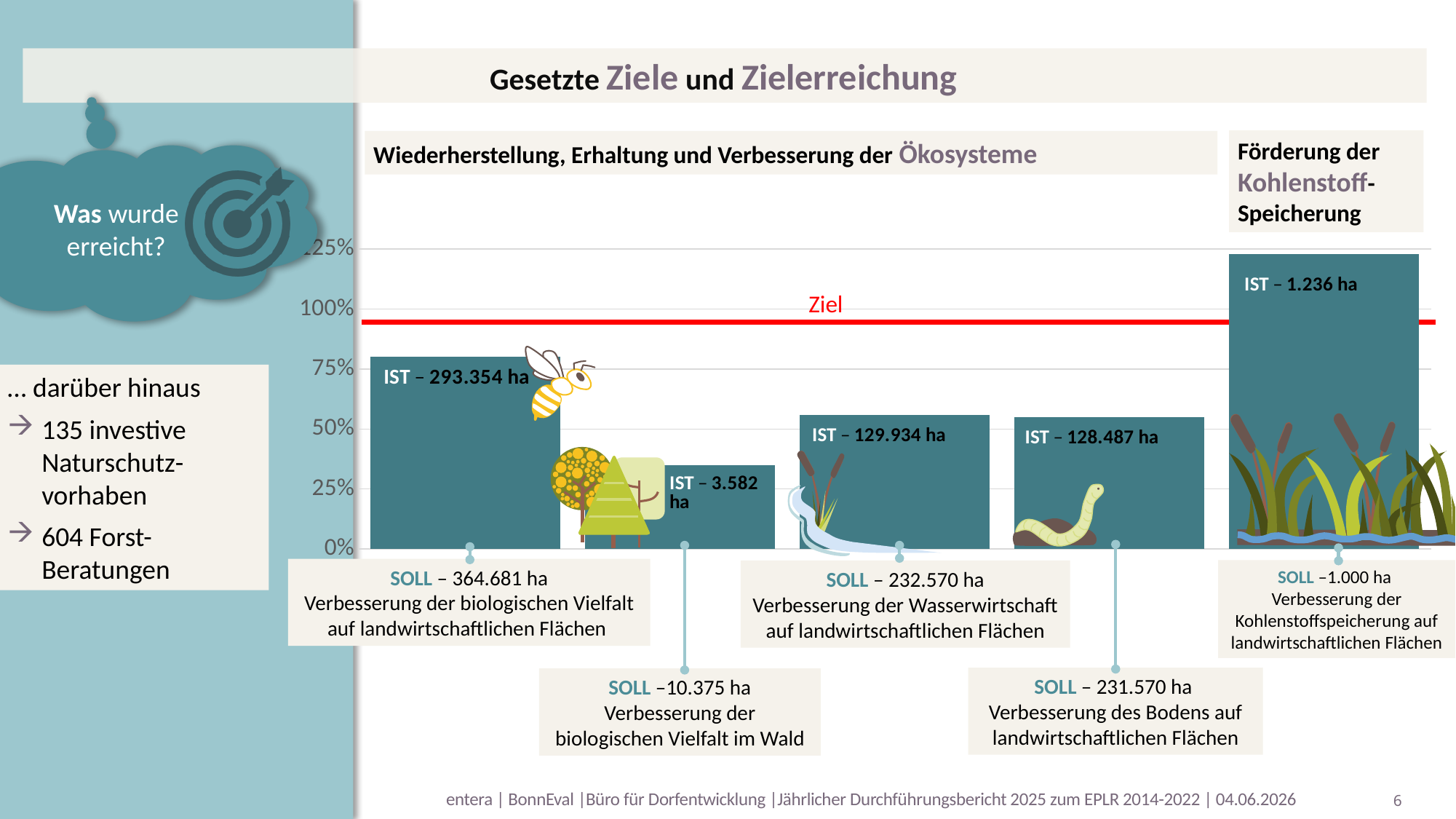
Is the bar for Verbesserung der biologischen Vielfalt im Wald greater or less than 50%? less What is the SOLL value for Verbesserung der biologischen Vielfalt im Wald? 10.375 ha What is the SOLL value for Verbesserung des Bodens auf landwirtschaftlichen Flächen? 231.570 ha Is the bar for Verbesserung der biologischen Vielfalt auf landwirtschaftlichen Flächen greater or less than 75%? greater What is the IST value for Verbesserung der Kohlenstoffspeicherung auf landwirtschaftlichen Flächen? 1.236 ha Which measure has the lowest bar (degree of target achievement) in the chart? Verbesserung der biologischen Vielfalt im Wald Which measure has the highest bar (degree of target achievement) in the chart? Verbesserung der Kohlenstoffspeicherung auf landwirtschaftlichen Flächen What kind of chart is shown on the slide? bar chart What is the IST value for Verbesserung der Wasserwirtschaft auf landwirtschaftlichen Flächen? 129.934 ha How many bars (measures) are shown in the chart? 5 What is the IST value for Verbesserung der biologischen Vielfalt auf landwirtschaftlichen Flächen? 293.354 ha